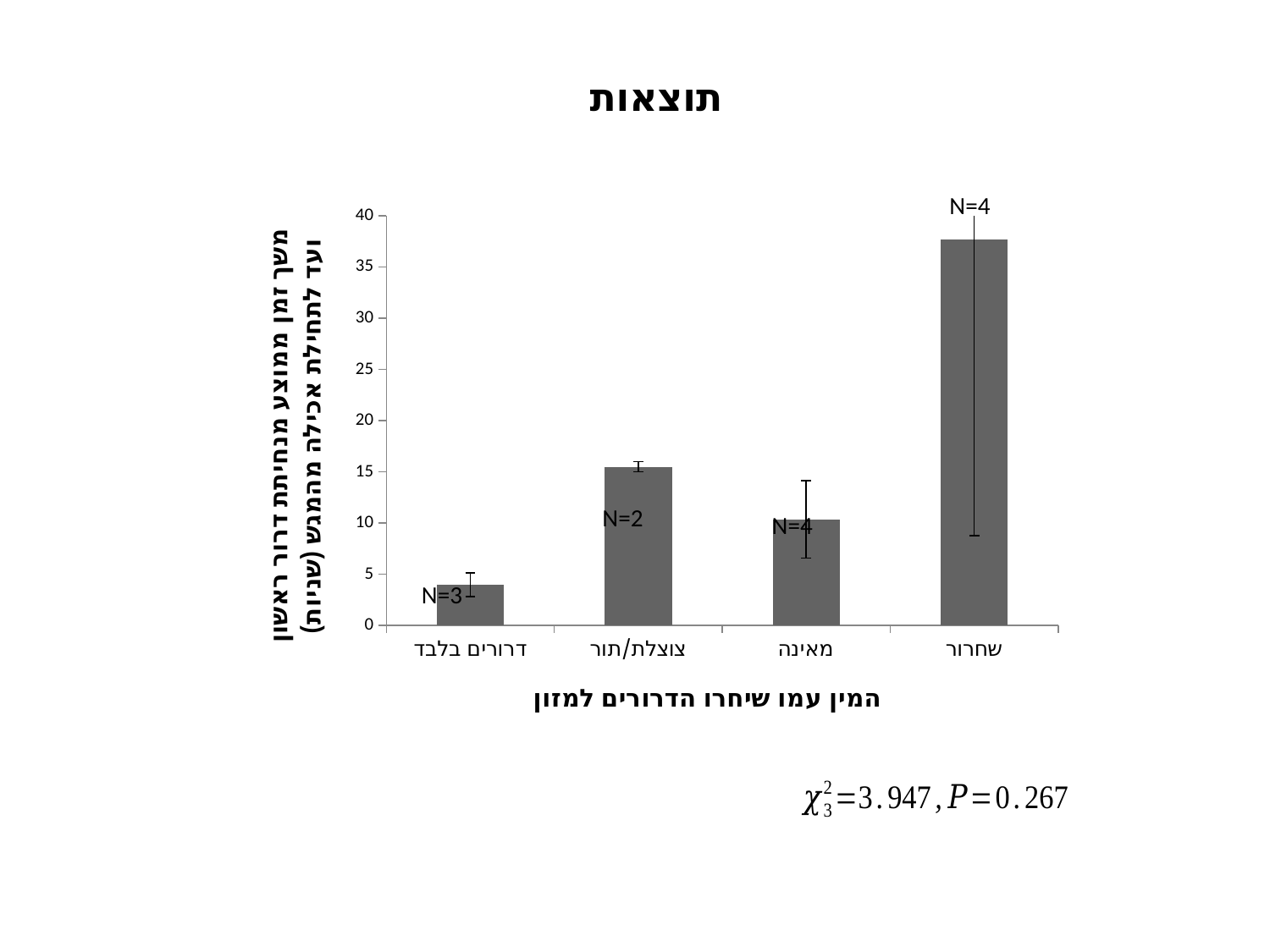
Which bar is taller, צוצלת/תור or מאינה? צוצלת/תור What kind of chart is shown on the slide? bar chart What N value is printed above the שחרור bar? N=4 What is the title of the slide above the chart? תוצאות Which category has the lowest bar in the chart? דרורים בלבד Is the value for צוצלת/תור greater or less than 10? greater Which category has the highest bar in the chart? שחרור Is the value for שחרור greater or less than 35? greater Is the value for מאינה greater or less than 15? less How many categories are shown on the x axis of the chart? 4 Which bar is taller, מאינה or דרורים בלבד? מאינה